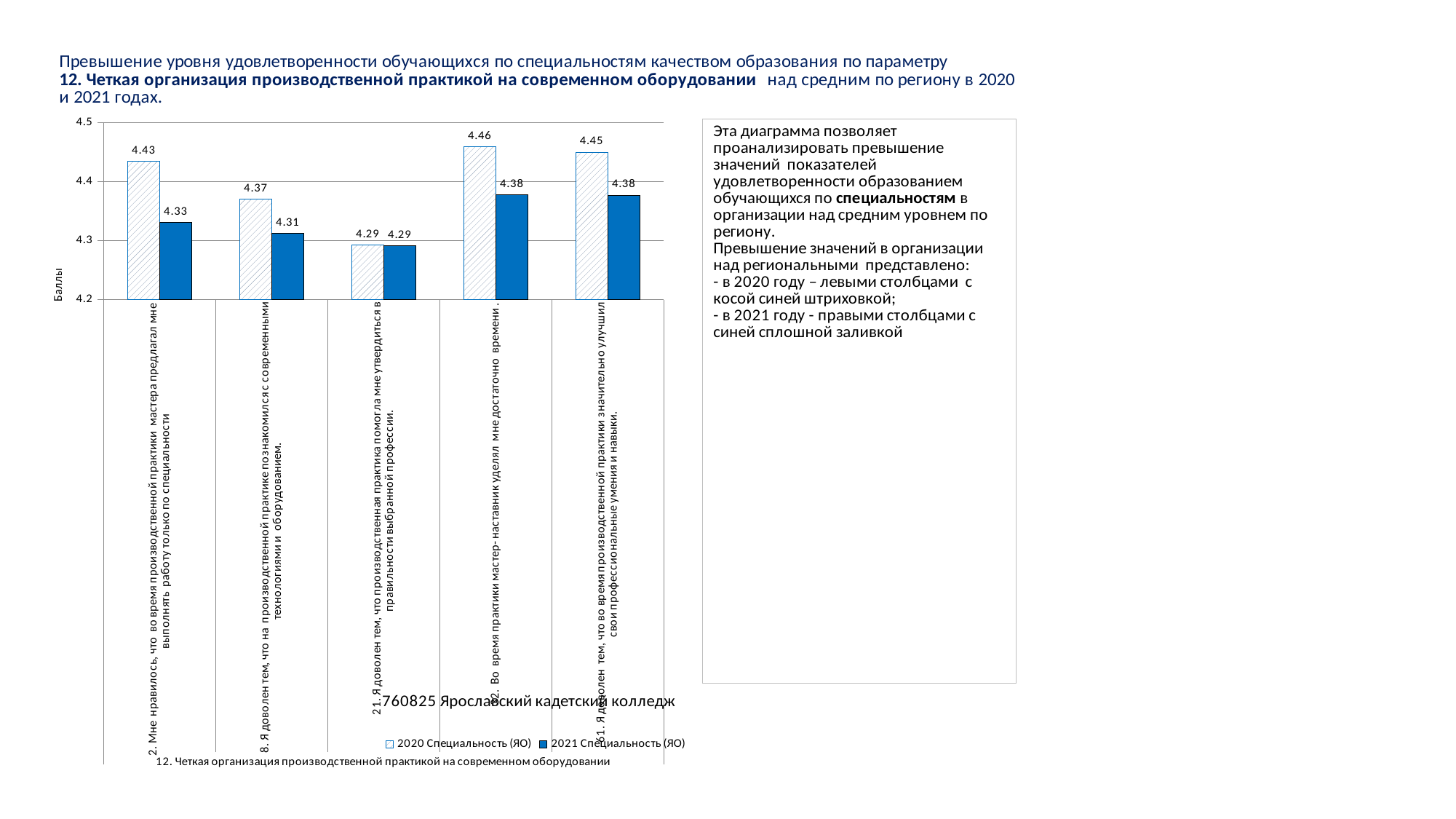
What is the value of the 2021 Специальность (ЯО) series for category 32 ("Во время практики мастер-наставник уделял мне достаточно времени")? 4.38 What type of chart is shown on the slide? Bar chart How many series does the chart legend list? 2 What is the value of the 2021 Специальность (ЯО) series for category 8 ("Я доволен тем, что на производственной практике познакомился с современными технологиями и оборудованием")? 4.31 Is the 2020 value for category 8 ("Я доволен тем, что на производственной практике познакомился с современными технологиями и оборудованием") greater or less than 4.3? greater What is the label of the vertical axis of the chart? Баллы What is the difference between the 2020 and 2021 values for category 2 ("Мне нравилось, что во время производственной практики мастера предлагал мне выполнять работу только по специальности")? 0.10 Which category has the highest value in the 2020 Специальность (ЯО) series? 32. Во время практики мастер-наставник уделял мне достаточно времени What is the value of the 2020 Специальность (ЯО) series for category 2 ("Мне нравилось, что во время производственной практики мастера предлагал мне выполнять работу только по специальности")? 4.43 Which category has the lowest value in the 2021 Специальность (ЯО) series? 21. Я доволен тем, что производственная практика помогла мне утвердиться в правильности выбранной профессии How many categories are shown on the x axis of the chart? 5